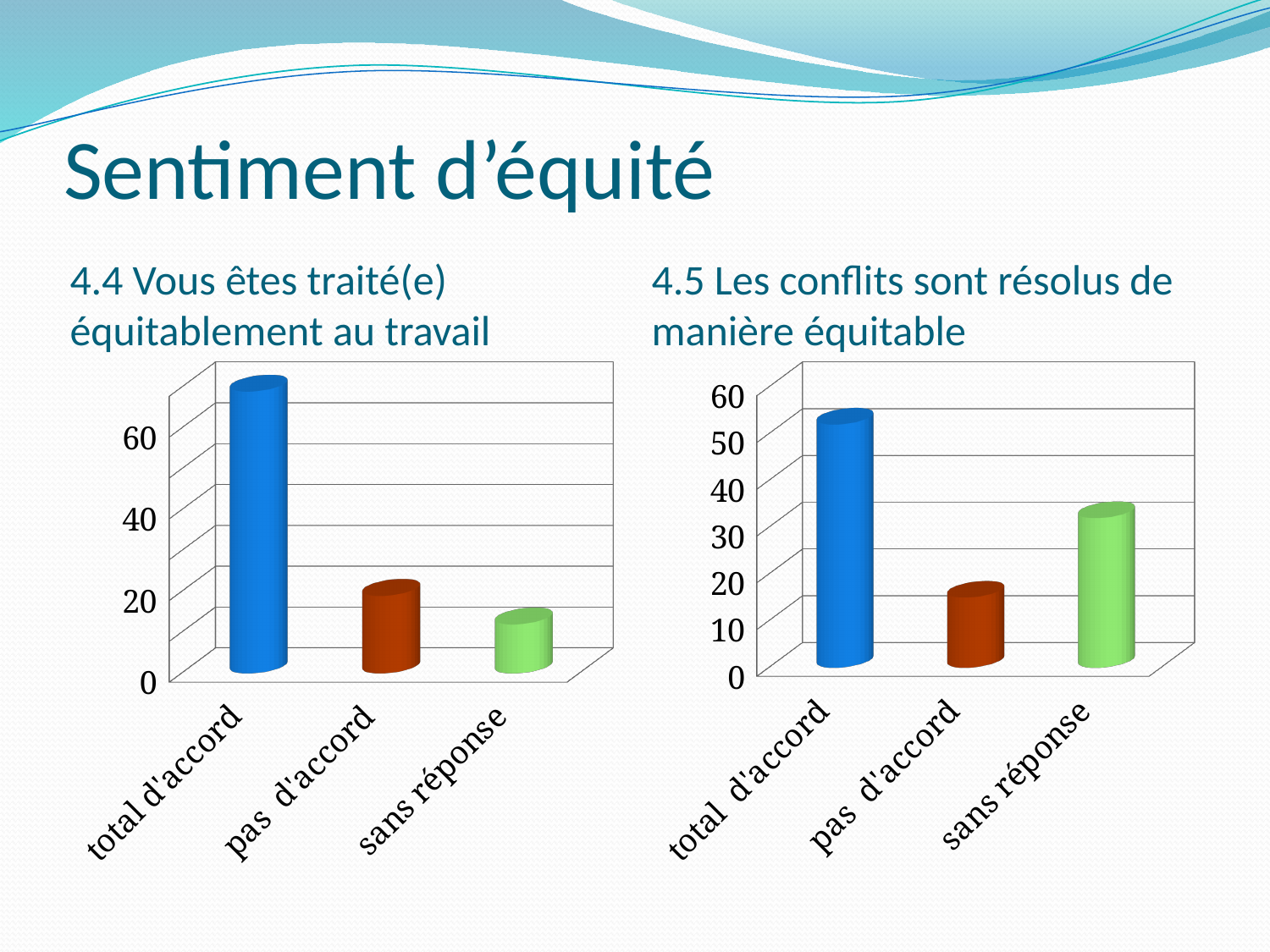
In the chart titled "4.5 Les conflits sont résolus de manière équitable", is the value for pas d'accord greater or less than 20? less In the chart titled "4.5 Les conflits sont résolus de manière équitable", which is larger: sans réponse or pas d'accord? sans réponse In the chart titled "4.4 Vous êtes traité(e) équitablement au travail", which category has the lowest value? sans réponse In the chart titled "4.5 Les conflits sont résolus de manière équitable", which category has the highest value? total d'accord In the chart titled "4.4 Vous êtes traité(e) équitablement au travail", how many categories are shown on the x axis? 3 What is the title of the chart on the left of the slide? 4.4 Vous êtes traité(e) équitablement au travail In the chart titled "4.4 Vous êtes traité(e) équitablement au travail", is the value for sans réponse greater or less than 20? less In the chart titled "4.5 Les conflits sont résolus de manière équitable", which category has the lowest value? pas d'accord In the chart titled "4.4 Vous êtes traité(e) équitablement au travail", which category has the highest value? total d'accord What kind of chart is the one on the right of the slide? bar chart In the chart titled "4.4 Vous êtes traité(e) équitablement au travail", is the value for total d'accord greater or less than 60? greater